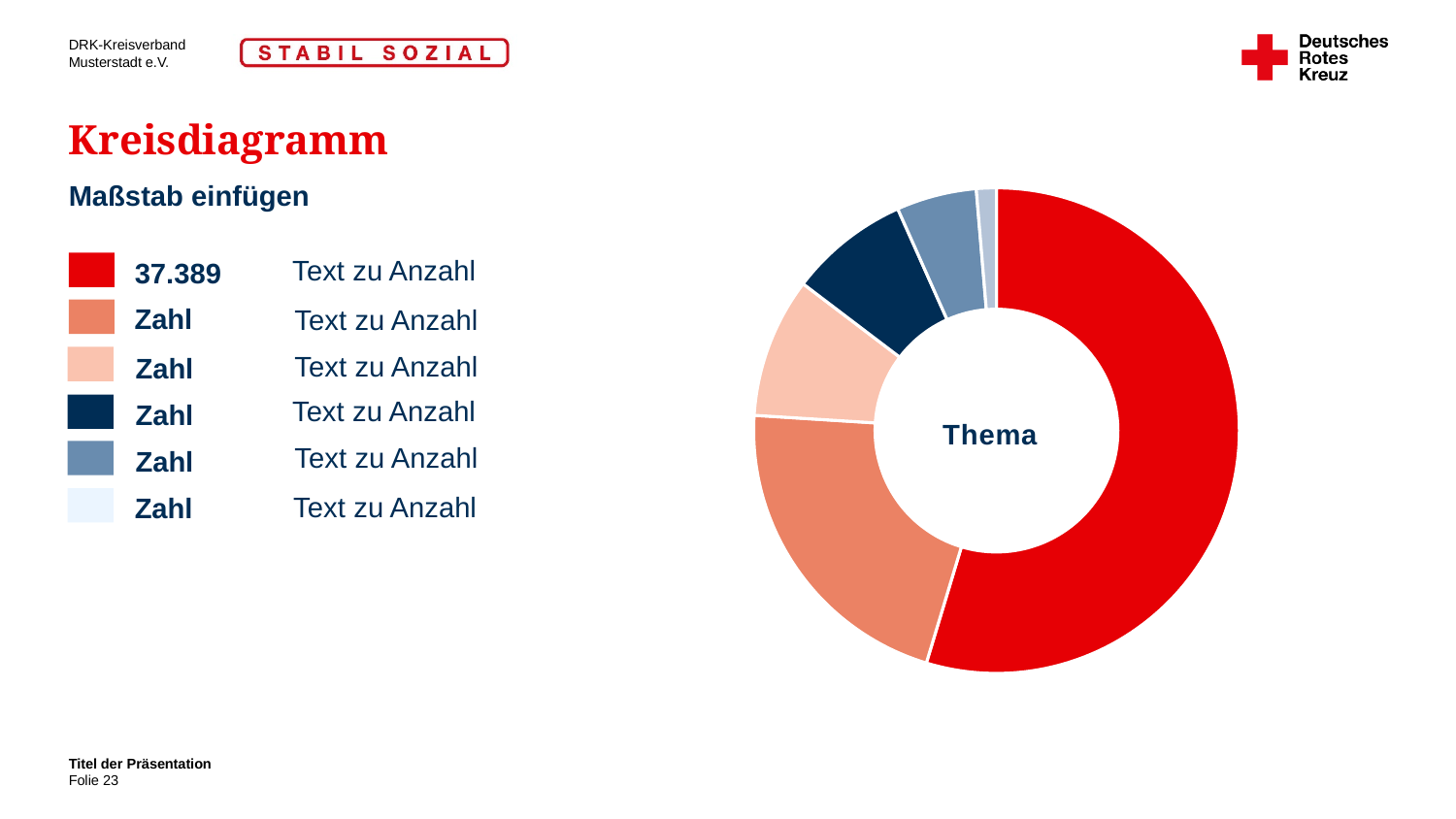
How many slices does the donut chart have? 6 Does the red slice take up more or less than half of the donut chart? More Which slice is larger, the dark navy slice or the light peach slice? The light peach slice What text is shown in the centre of the donut chart? Thema Which slice of the donut chart is the largest? The red slice (37.389) How many entries does the legend to the left of the chart list? 6 Which slice is larger, the red slice or the salmon/orange slice? The red slice Which slice of the donut chart is the smallest? The very light blue slice (last legend entry) What value is shown in the legend for the red slice? 37.389 What kind of chart is shown on the slide? Pie chart (donut) What is the title of the slide containing the chart? Kreisdiagramm